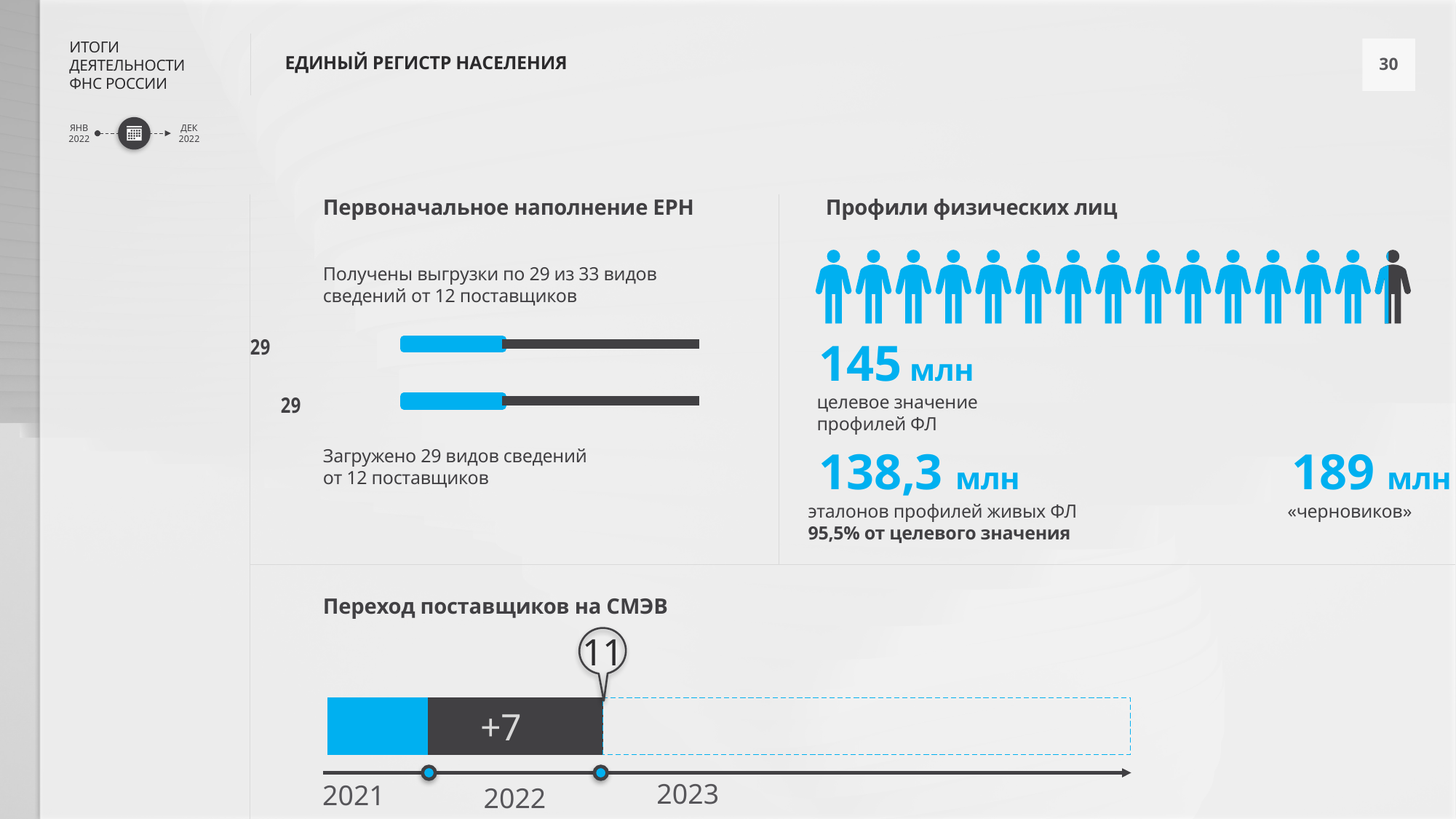
In the "Профили физических лиц" section, what is the target value of individual profiles (целевое значение профилей ФЛ)? 145 млн In the "Переход поставщиков на СМЭВ" chart, what value is shown in the callout at the end of the 2022 segment? 11 In the "Первоначальное наполнение ЕРН" chart, what value is labelled on the bottom bar? 29 What kind of chart is shown under "Первоначальное наполнение ЕРН"? bar chart In the "Профили физических лиц" section, how many reference profiles of living individuals (эталонов профилей живых ФЛ) are shown? 138,3 млн In the "Профили физических лиц" section, how many «черновиков» are shown? 189 млн How many bars are shown in the "Первоначальное наполнение ЕРН" chart? 2 In the "Профили физических лиц" section, what is the difference between the target value (145 млн) and the reference profiles of living individuals (138,3 млн)? 6,7 млн In the "Профили физических лиц" section, which is larger: the target value of profiles or the number of «черновиков»? «черновиков» (189 млн) In the "Профили физических лиц" section, what percentage of the target value do the reference profiles of living individuals represent? 95,5% In the "Первоначальное наполнение ЕРН" chart, what value is labelled on the top bar? 29 In the "Переход поставщиков на СМЭВ" chart, what value is printed on the dark segment for 2022? +7